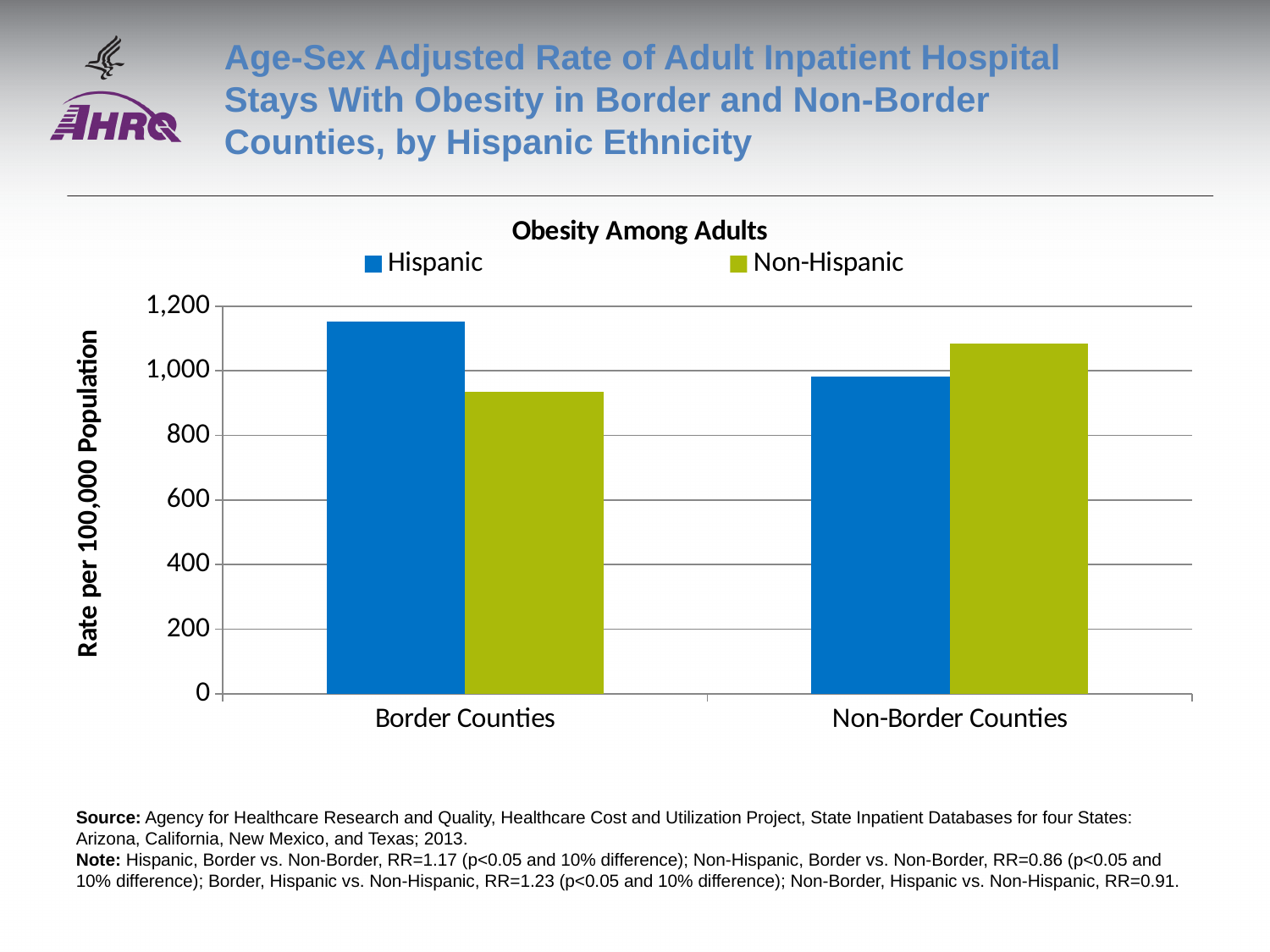
In Border Counties, which group has the higher rate, Hispanic or Non-Hispanic? Hispanic What kind of chart is shown on the slide? Bar chart For the Hispanic series, is the rate higher in Border Counties or Non-Border Counties? Border Counties Is the value for Hispanic in Non-Border Counties greater or less than 800? greater What is the label on the vertical axis? Rate per 100,000 Population How many county categories are shown on the x axis? 2 Which bar is the highest in the chart? Hispanic, Border Counties How many series does the legend list? 2 In Non-Border Counties, which group has the higher rate, Hispanic or Non-Hispanic? Non-Hispanic Is the value for Non-Hispanic in Border Counties greater or less than 1,000? less Is the value for Non-Hispanic in Non-Border Counties greater or less than 1,000? greater